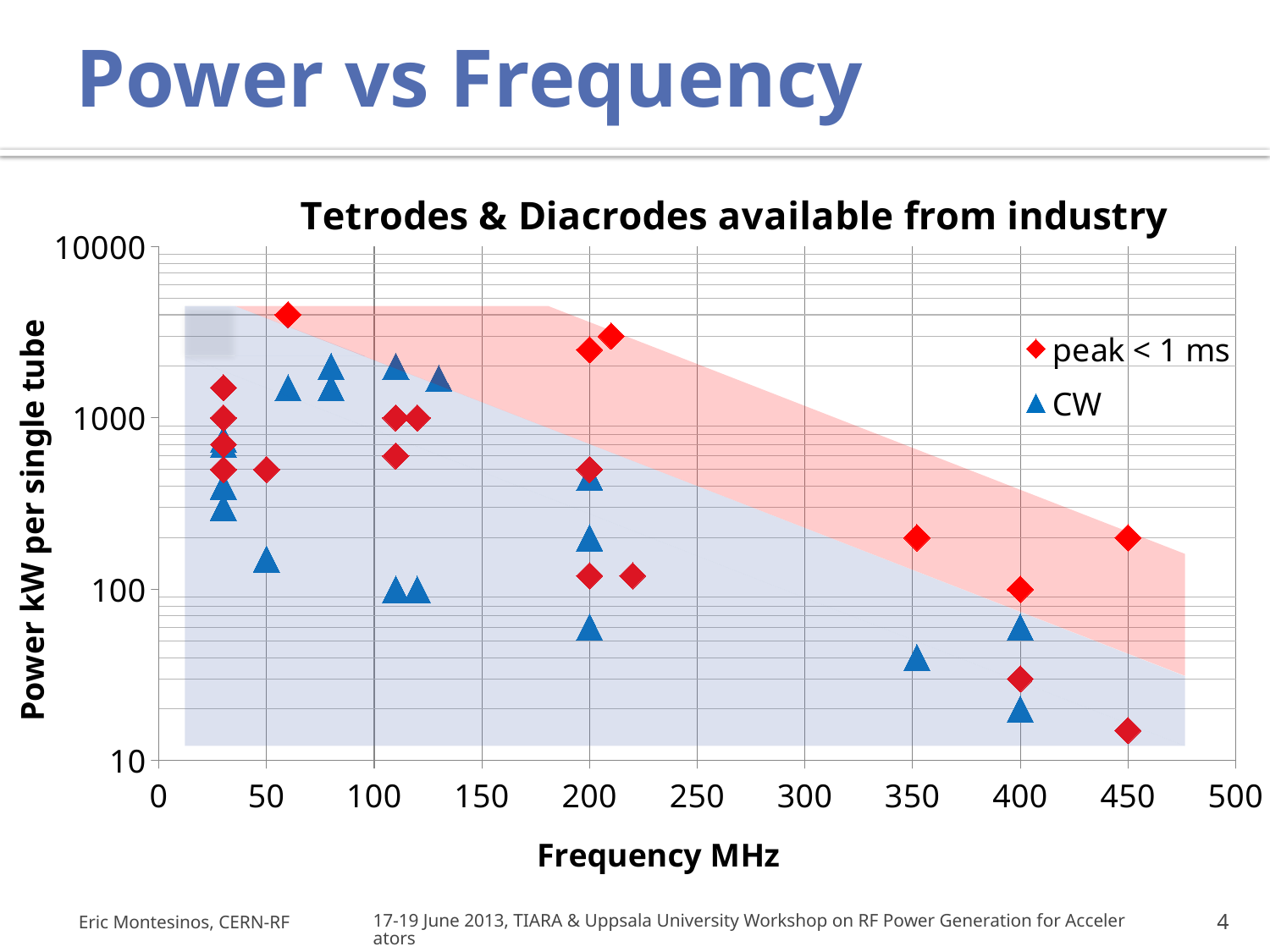
Is the CW point at about 350 MHz greater or less than 100 kW? less What kind of chart is shown on the slide? scatter chart How many series does the chart legend list? 2 Is the highest CW point greater or less than 1000 kW? greater As frequency increases along the x axis, do the maximum available power values rise or fall? fall At about 350 MHz, which series has the higher power value, peak < 1 ms or CW? peak < 1 ms Which series contains the point with the highest power on the chart? peak < 1 ms Is the highest peak < 1 ms point (near 60 MHz) greater or less than 1000 kW? greater What are the two series named in the chart legend? peak < 1 ms and CW At about 200 MHz, which series has the highest-power point, peak < 1 ms or CW? peak < 1 ms What is the title of the chart? Tetrodes & Diacrodes available from industry